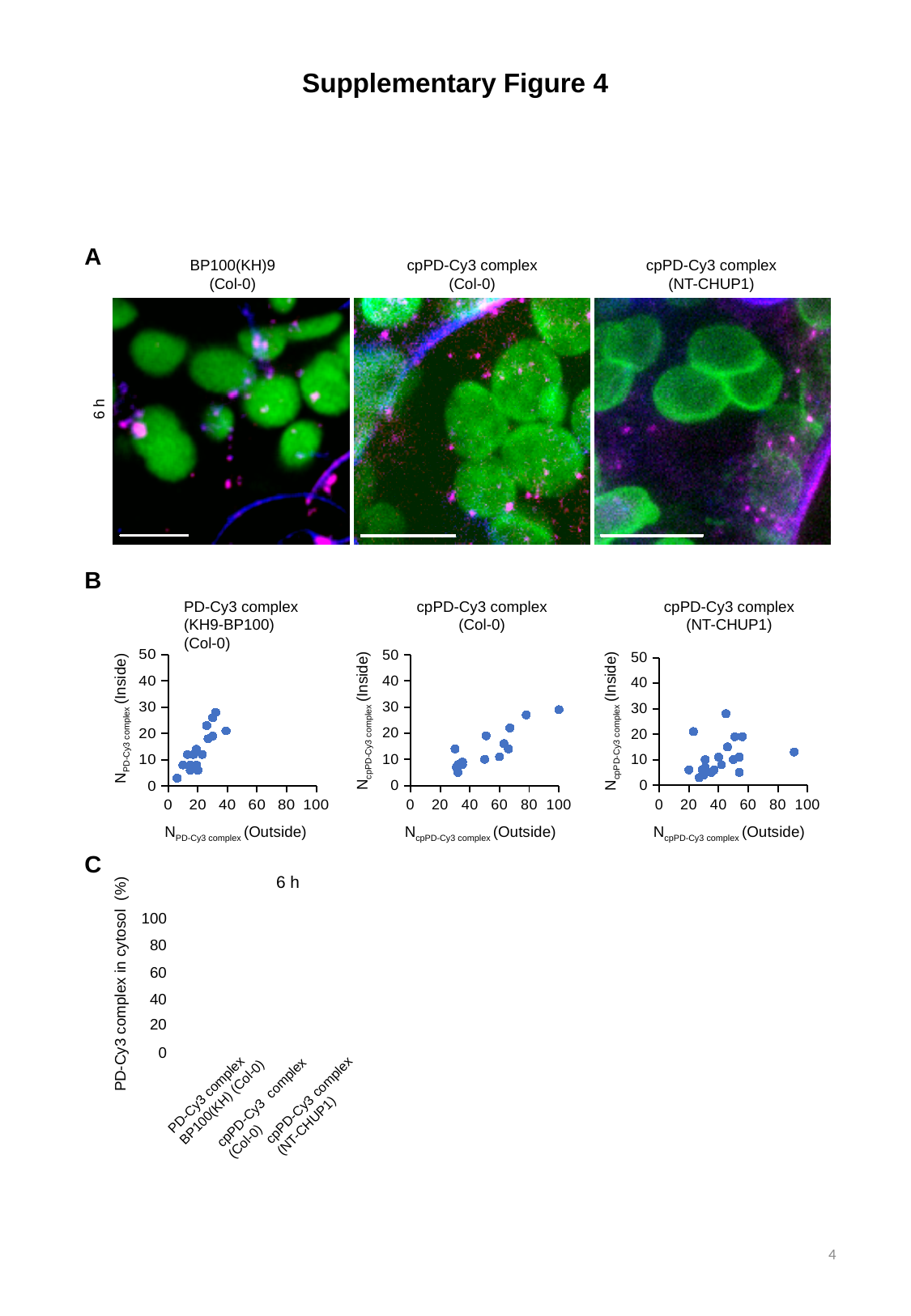
In the 'cpPD-Cy3 complex (Col-0)' chart in panel B, is the lowest Outside value greater or less than 20? greater In the 'cpPD-Cy3 complex (NT-CHUP1)' chart in panel B, is the highest Inside value greater or less than 40? less What is the maximum value shown on the y axis of the panel B charts? 50 How many scatter plots are shown in panel B? 3 In the 'PD-Cy3 complex (KH9-BP100) (Col-0)' chart in panel B, is the highest Inside value greater or less than 40? less What is the y-axis label of the panel C chart? PD-Cy3 complex in cytosol (%) What kind of chart is the 'cpPD-Cy3 complex (Col-0)' chart in panel B? scatter plot How many categories are listed on the x axis of the panel C chart? 3 In the 'cpPD-Cy3 complex (Col-0)' chart in panel B, do the Inside values generally rise or fall as the Outside values increase? rise